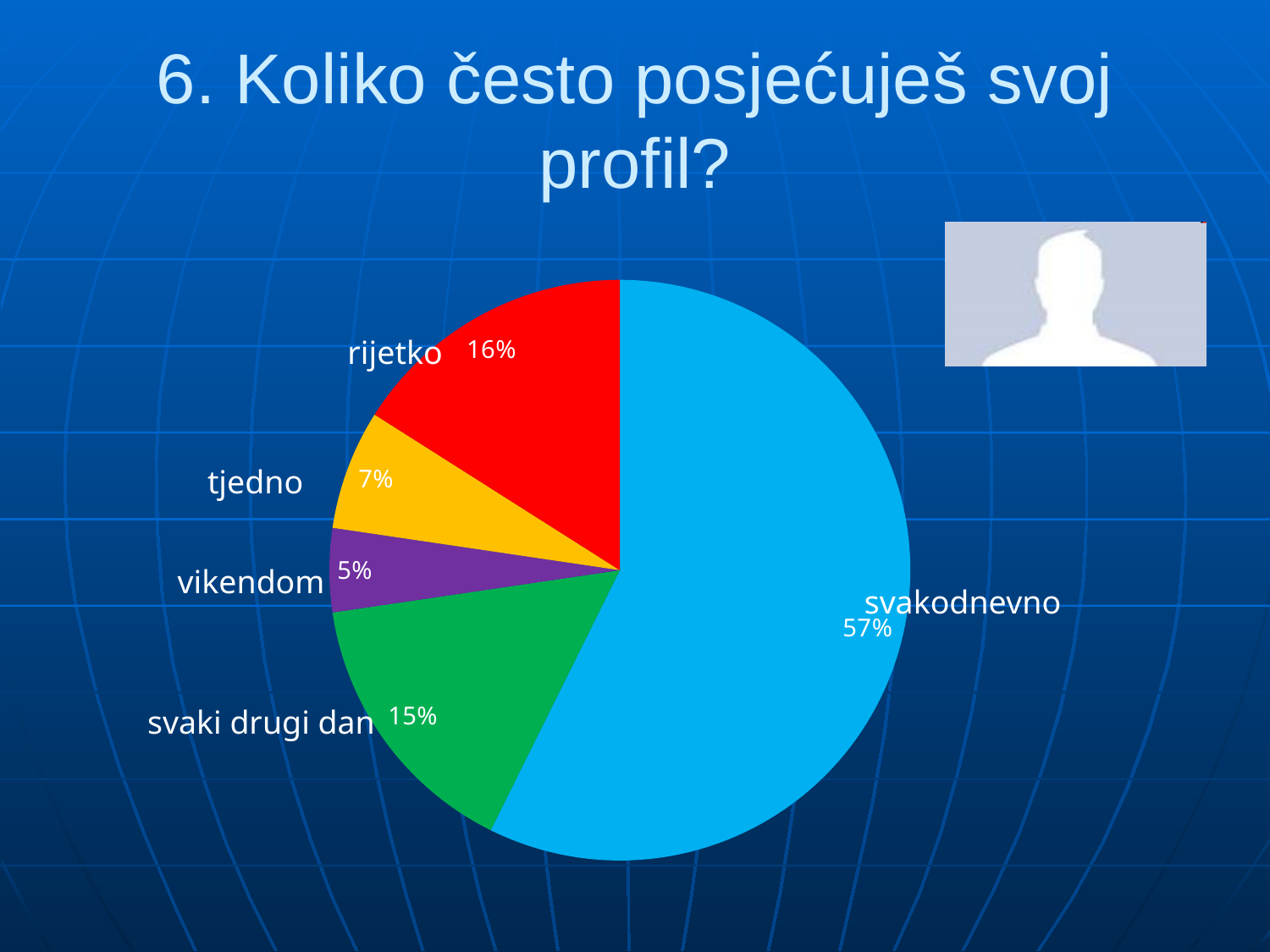
What percentage of respondents visit their profile 'svakodnevno'? 57% What colour is the 'svakodnevno' slice? light blue What kind of chart is shown on the slide? pie chart Which category has the smallest share of the pie? vikendom What is the value for 'tjedno'? 7% What is the value for 'rijetko'? 16% How many slices does the pie chart have? 5 Which is larger, the share for 'tjedno' or the share for 'svaki drugi dan'? svaki drugi dan What is the value for 'vikendom'? 5% What is the value for 'svaki drugi dan'? 15% Which category has the largest share of the pie? svakodnevno What is the difference between the 'svakodnevno' and 'rijetko' shares? 41%